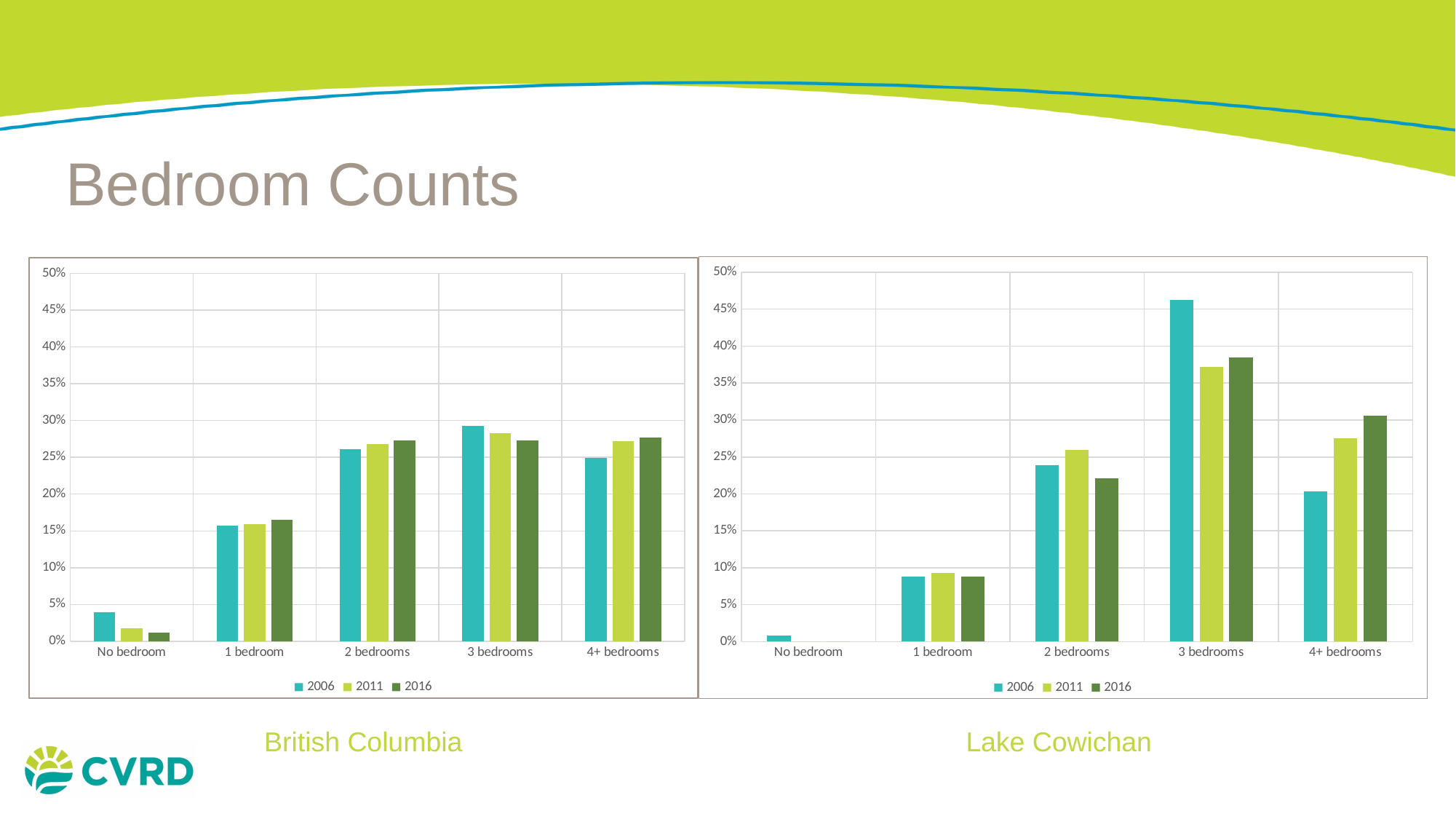
In the Lake Cowichan chart, is the 2006 value for 3 bedrooms greater or less than 45%? greater In the Lake Cowichan chart, do the values for 4+ bedrooms rise or fall from 2006 to 2016? rise In the British Columbia chart, which category has the tallest bar? 3 bedrooms In the Lake Cowichan chart, which category has the tallest bar? 3 bedrooms In the Lake Cowichan chart, which category has the lowest values? No bedroom How many bedroom categories are shown on the x axis of the British Columbia chart? 5 What type of chart is the British Columbia chart? bar chart In the British Columbia chart, is the 2006 value for No bedroom greater or less than 5%? less In the Lake Cowichan chart, is the 2011 value for 1 bedroom greater or less than 10%? less In the Lake Cowichan chart, which is larger for 4+ bedrooms: the 2006 value or the 2016 value? 2016 For 3 bedrooms in 2006, which chart shows the larger value: British Columbia or Lake Cowichan? Lake Cowichan How many series does the legend of the Lake Cowichan chart list? 3